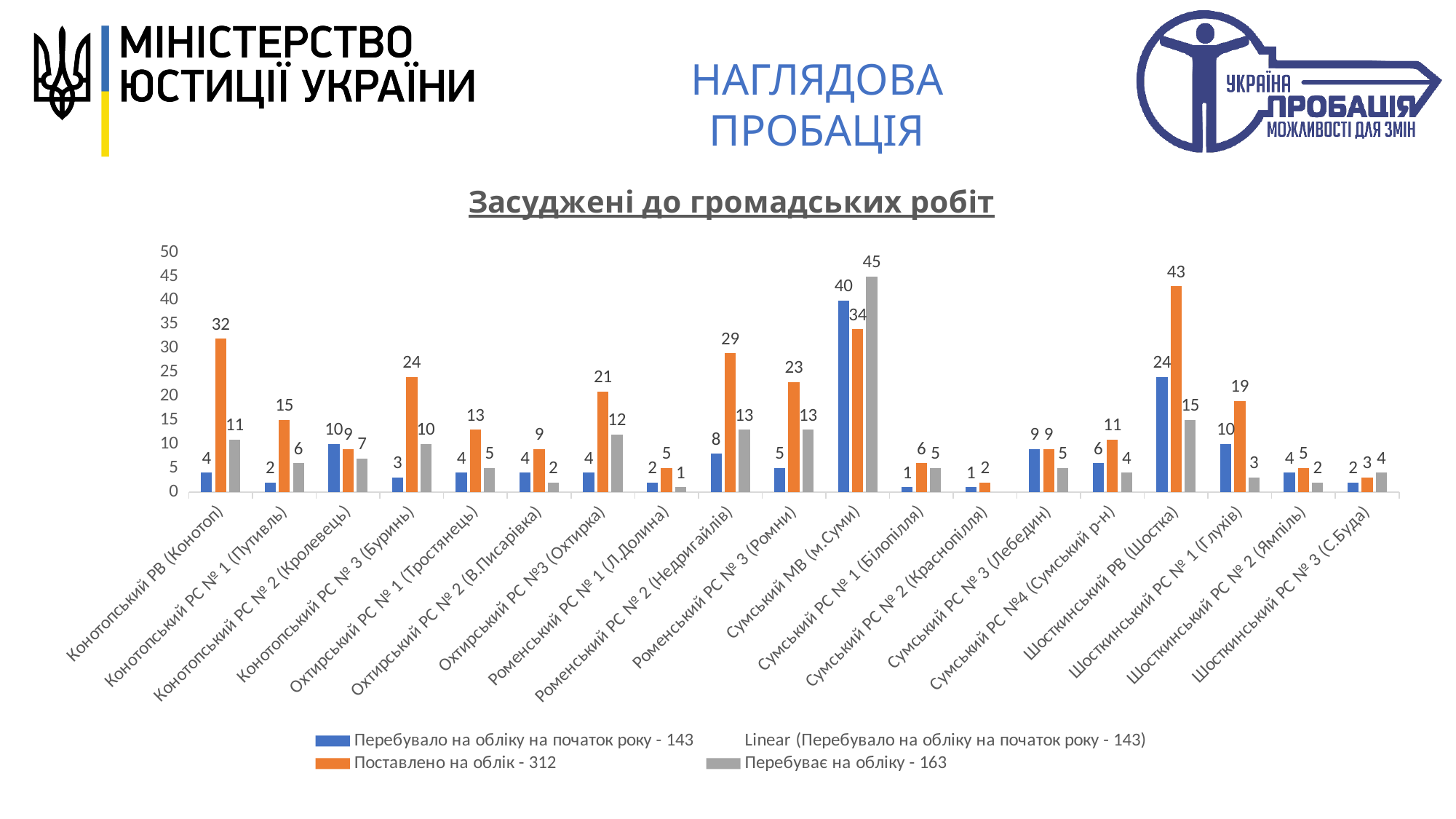
What is the title of the chart? Засуджені до громадських робіт What is the value of 'Перебуває на обліку - 163' for Шосткинський РС № 1 (Глухів)? 3 How many categories are shown on the x axis of the chart? 19 What is the value of 'Перебувало на обліку на початок року - 143' for Шосткинський РВ (Шостка)? 24 Which category has the highest value for 'Поставлено на облік - 312'? Шосткинський РВ (Шостка) Which is larger for Сумський МВ (м.Суми): 'Перебувало на обліку на початок року - 143' or 'Поставлено на облік - 312'? Перебувало на обліку на початок року - 143 What is the difference between 'Поставлено на облік - 312' and 'Перебувало на обліку на початок року - 143' for Роменський РС № 2 (Недригайлів)? 21 What type of chart is shown on the slide? bar chart Which category has the highest value for 'Перебувало на обліку на початок року - 143'? Сумський МВ (м.Суми) What is the value of 'Поставлено на облік - 312' for Конотопський РВ (Конотоп)? 32 How many entries does the chart legend list? 4 What is the value of 'Перебуває на обліку - 163' for Сумський МВ (м.Суми)? 45